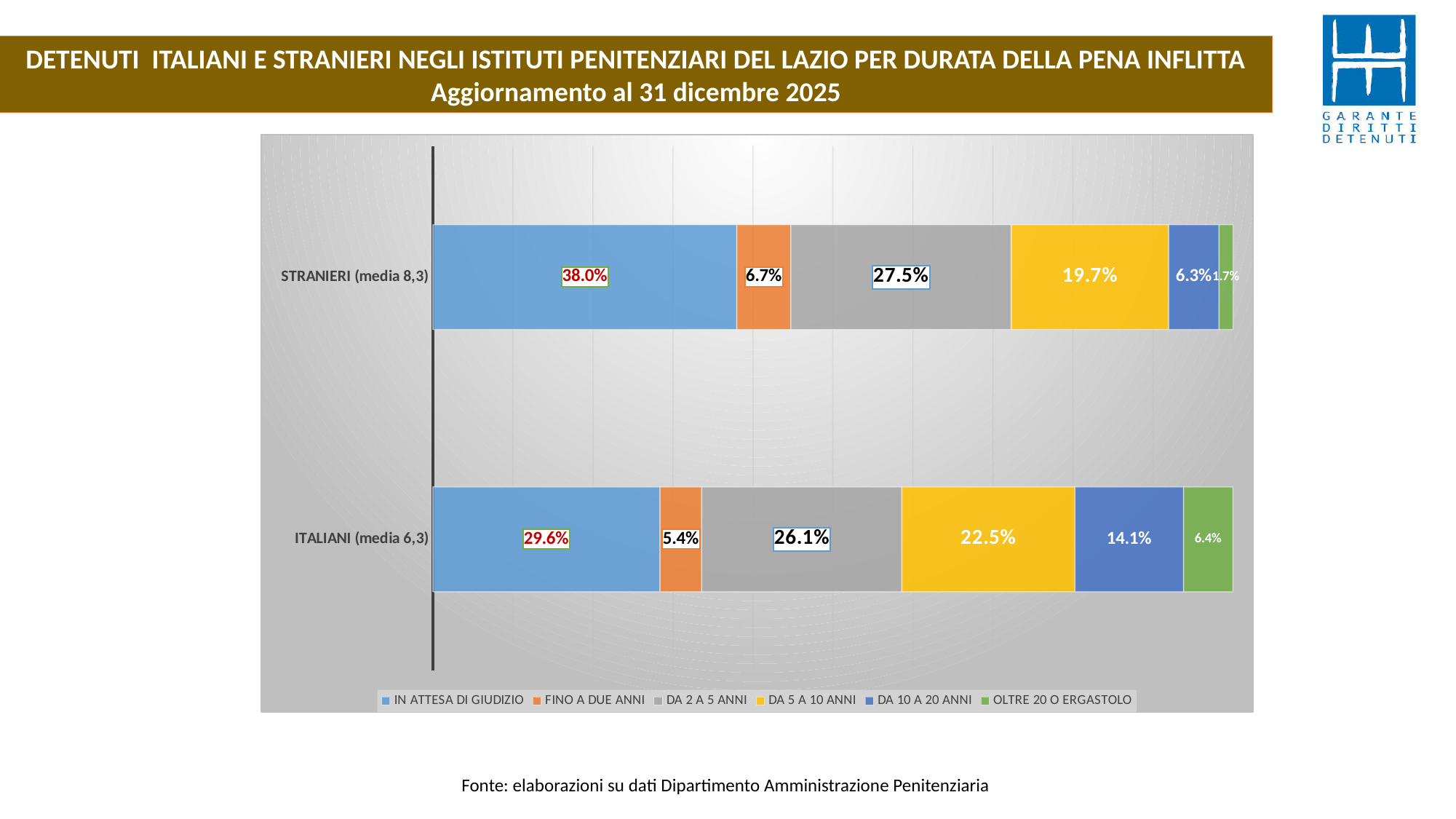
How many series does the legend list? 6 What is the value for DA 5 A 10 ANNI in the ITALIANI (media 6,3) bar? 22.5% Which colour represents DA 5 A 10 ANNI in the legend? Yellow How many categories (bars) does the chart show? 2 What is the value for DA 10 A 20 ANNI in the ITALIANI (media 6,3) bar? 14.1% Which series has the smallest share in the STRANIERI (media 8,3) bar? OLTRE 20 O ERGASTOLO Which series has the largest share in the ITALIANI (media 6,3) bar? IN ATTESA DI GIUDIZIO What is the value for OLTRE 20 O ERGASTOLO in the STRANIERI (media 8,3) bar? 1.7% What kind of chart is shown on the slide? Stacked bar chart What is the value for IN ATTESA DI GIUDIZIO in the STRANIERI (media 8,3) bar? 38.0% What is the difference between the IN ATTESA DI GIUDIZIO values for STRANIERI and ITALIANI? 8.4% Which bar has the larger value for DA 10 A 20 ANNI, STRANIERI or ITALIANI? ITALIANI